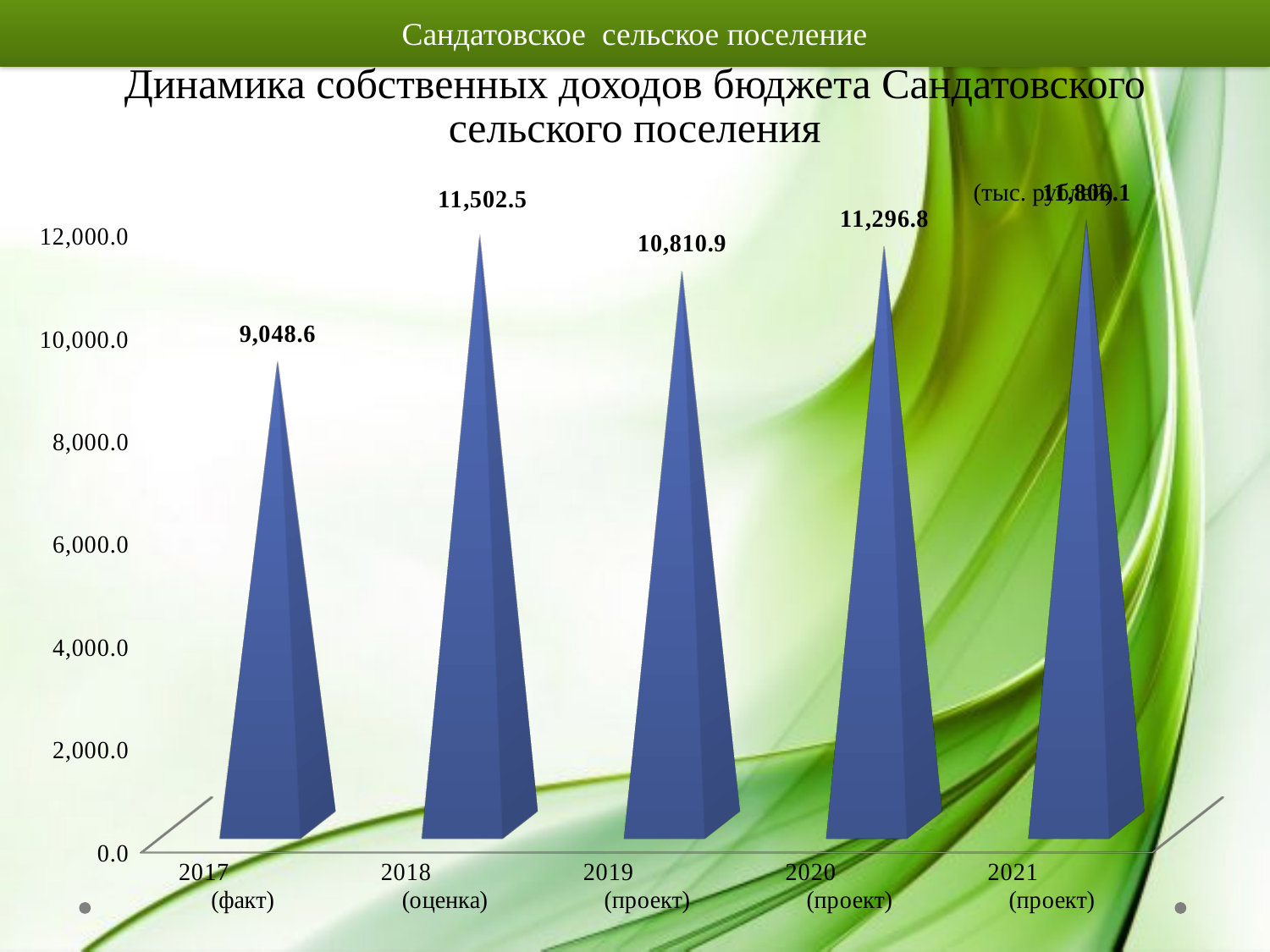
Does the value rise or fall from 2017 (факт) to 2018 (оценка)? rise Is the value for 2017 (факт) greater or less than 10,000.0? less What kind of chart is shown on the slide? bar chart Which is larger, the value for 2019 (проект) or 2020 (проект)? 2020 (проект) What is the value for 2018 (оценка)? 11,502.5 What is the difference between the values for 2018 (оценка) and 2017 (факт)? 2,453.9 What is the value for 2020 (проект)? 11,296.8 What is the value for 2019 (проект)? 10,810.9 How many years are shown on the x axis? 5 What is the difference between the values for 2018 (оценка) and 2019 (проект)? 691.6 What is the value for 2017 (факт)? 9,048.6 Which year has the lowest value? 2017 (факт)